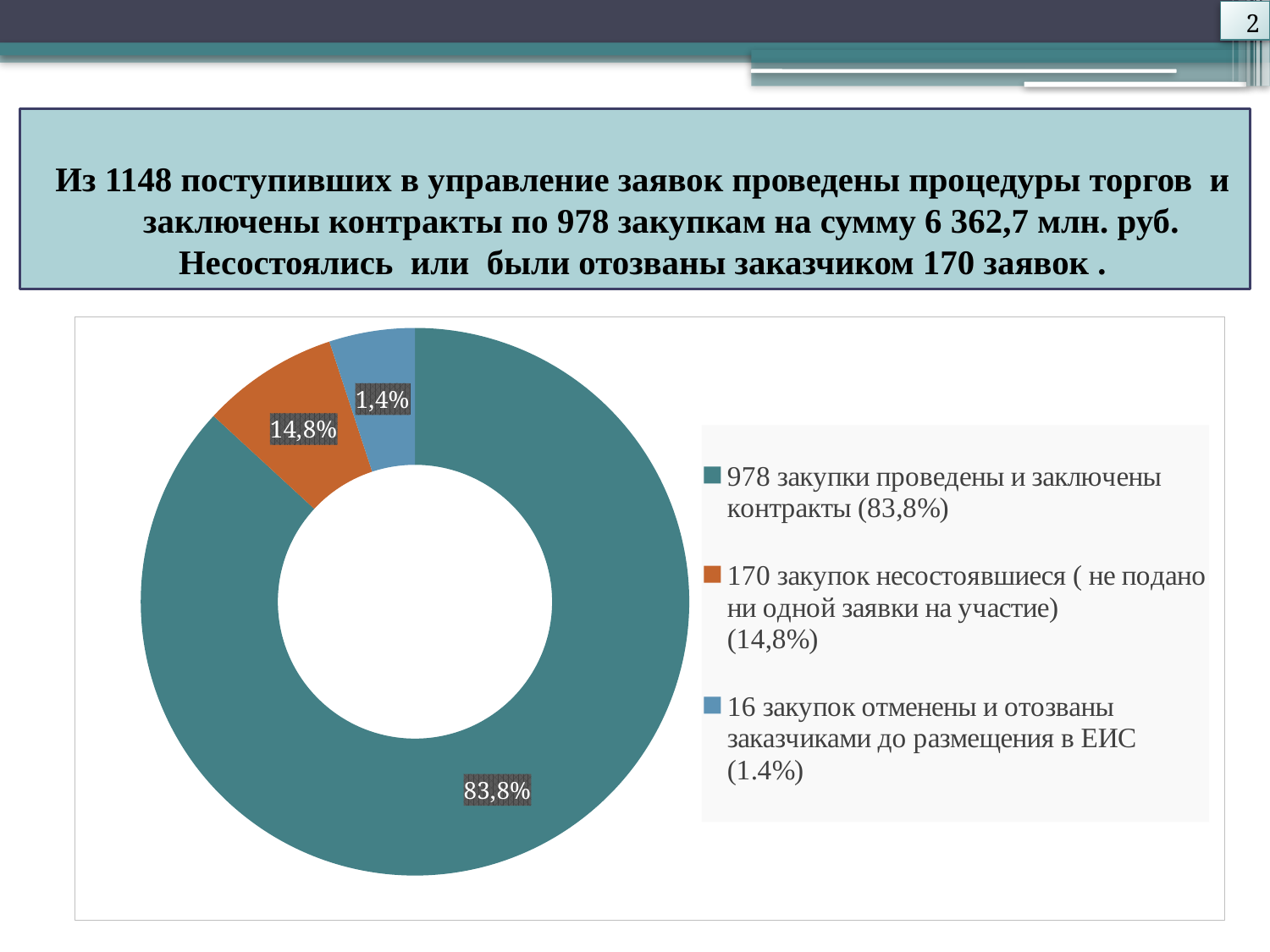
What is the difference in percentage points between the largest slice (83,8%) and the slice for 170 закупок несостоявшиеся (14,8%)? 69,0% Which slice of the chart is the largest? 978 закупки проведены и заключены контракты (83,8%) Which is larger: the share for 170 закупок несостоявшиеся or the share for 16 закупок отменены и отозваны заказчиками? 170 закупок несостоявшиеся What colour is the largest slice of the chart (83,8%)? teal How many slices does the doughnut chart have? 3 What share of the chart is labelled for the slice '978 закупки проведены и заключены контракты'? 83,8% How many entries does the legend of the chart list? 3 What share of the chart is labelled for the slice '170 закупок несостоявшиеся'? 14,8% What share of the chart is labelled for the slice '16 закупок отменены и отозваны заказчиками до размещения в ЕИС'? 1,4% What kind of chart is shown on the slide? doughnut chart Which slice of the chart is the smallest? 16 закупок отменены и отозваны заказчиками до размещения в ЕИС (1.4%) What colour is the slice representing 170 закупок несостоявшиеся (14,8%)? orange